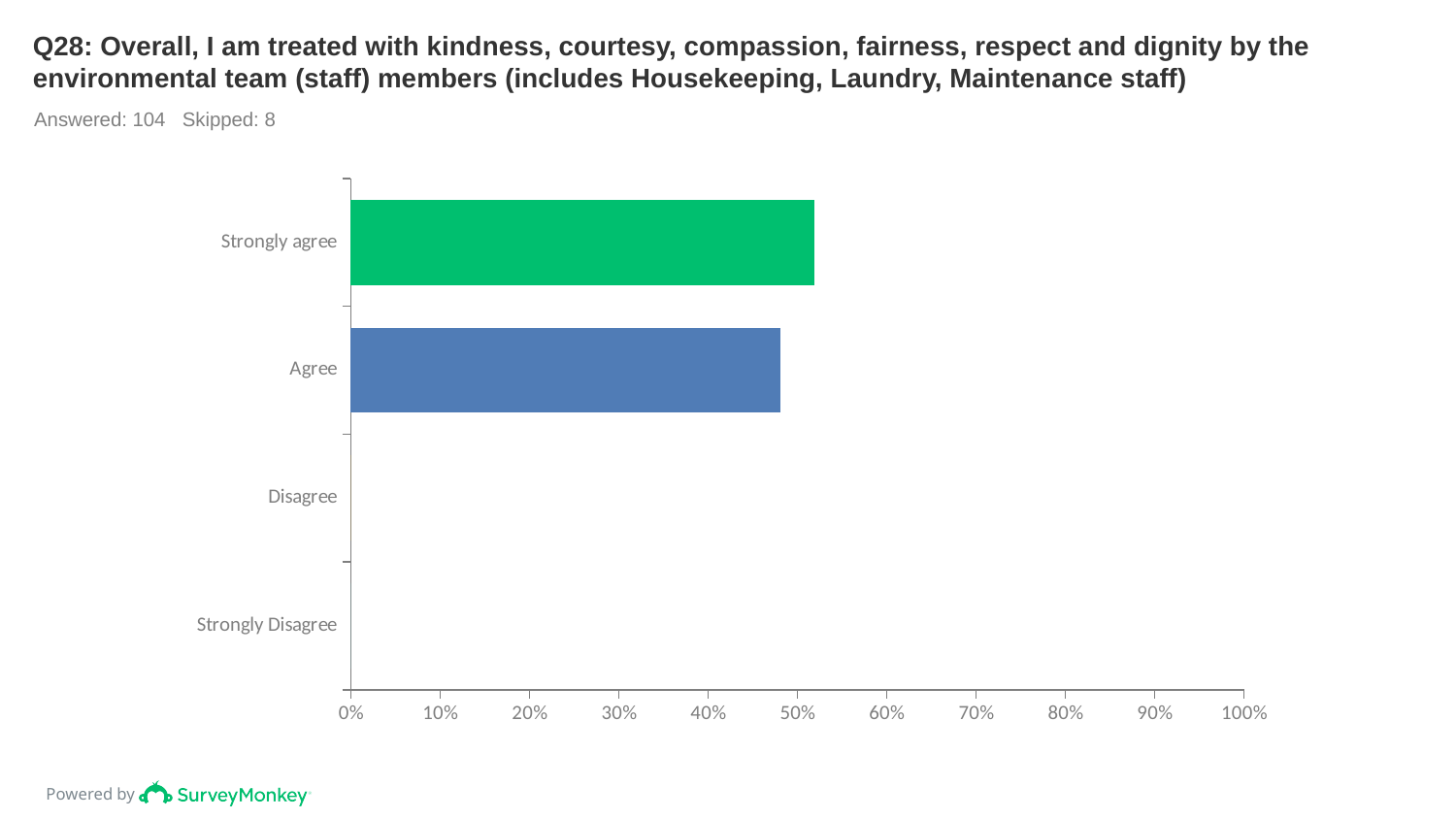
Is the value for Strongly agree greater or less than 60%? less What is the highest value shown on the horizontal axis? 100% Is the value for Agree greater or less than 40%? greater Is the value for Agree greater or less than 60%? less How many response categories have a visible bar on the chart? 2 What kind of chart is shown on the slide? bar chart Which response category has the longest bar? Strongly agree Which is larger, the value for Strongly agree or the value for Agree? Strongly agree How many respondents answered this question, according to the slide? 104 How many response categories are listed on the chart's vertical axis? 4